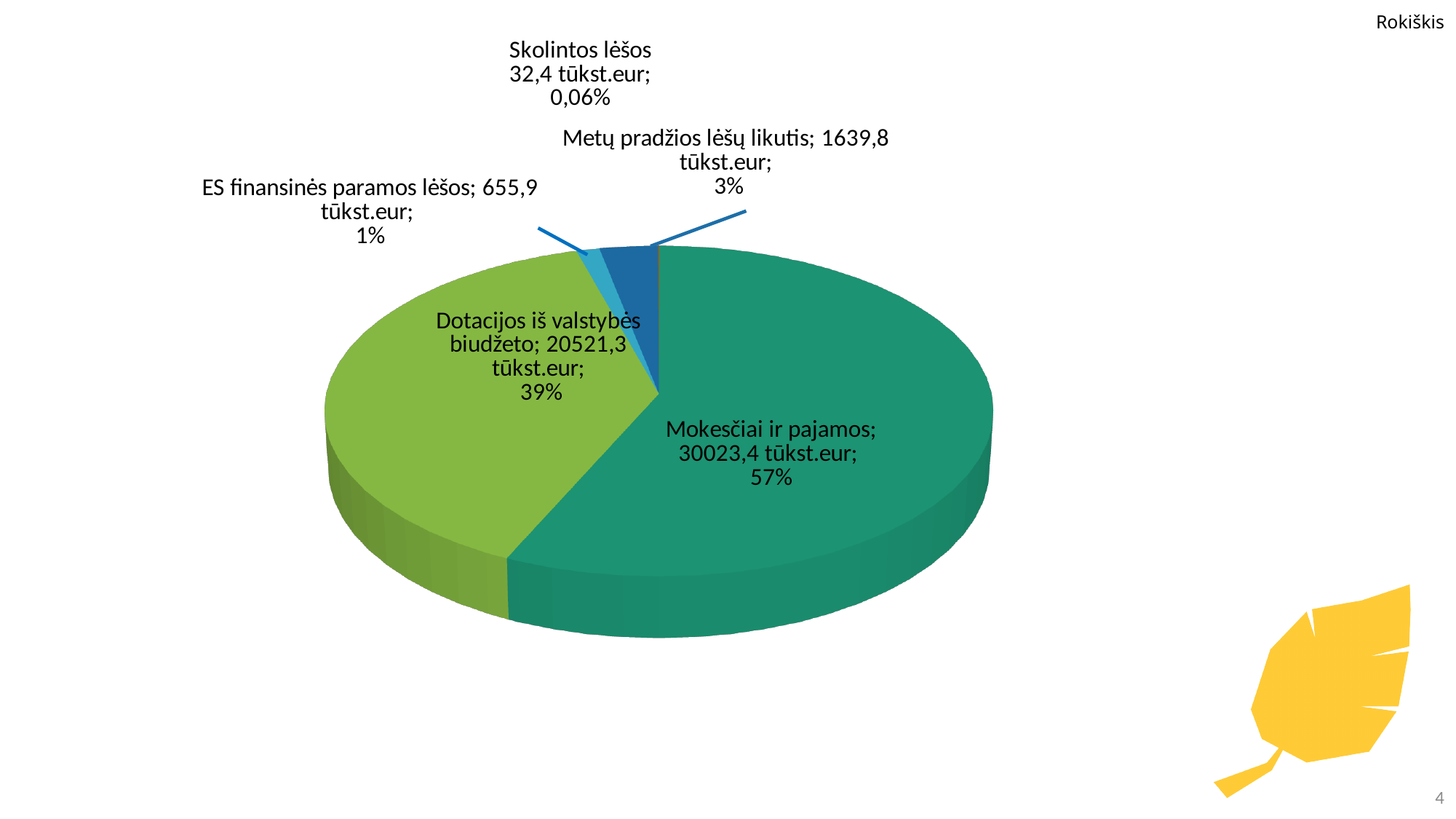
Which is larger, Metų pradžios lėšų likutis or ES finansinės paramos lėšos? Metų pradžios lėšų likutis What is the difference between the values for Mokesčiai ir pajamos and Dotacijos iš valstybės biudžeto? 9502,1 tūkst.eur What is the value for Metų pradžios lėšų likutis? 1639,8 tūkst.eur What share of the pie does Dotacijos iš valstybės biudžeto represent? 39% What is the value for Skolintos lėšos? 32,4 tūkst.eur What kind of chart is shown on the slide? pie chart What is the value for Dotacijos iš valstybės biudžeto? 20521,3 tūkst.eur What is the value for Mokesčiai ir pajamos? 30023,4 tūkst.eur Which category has the largest slice? Mokesčiai ir pajamos How many slices does the pie chart have? 5 Which category has the smallest slice? Skolintos lėšos What share of the pie does ES finansinės paramos lėšos represent? 1%